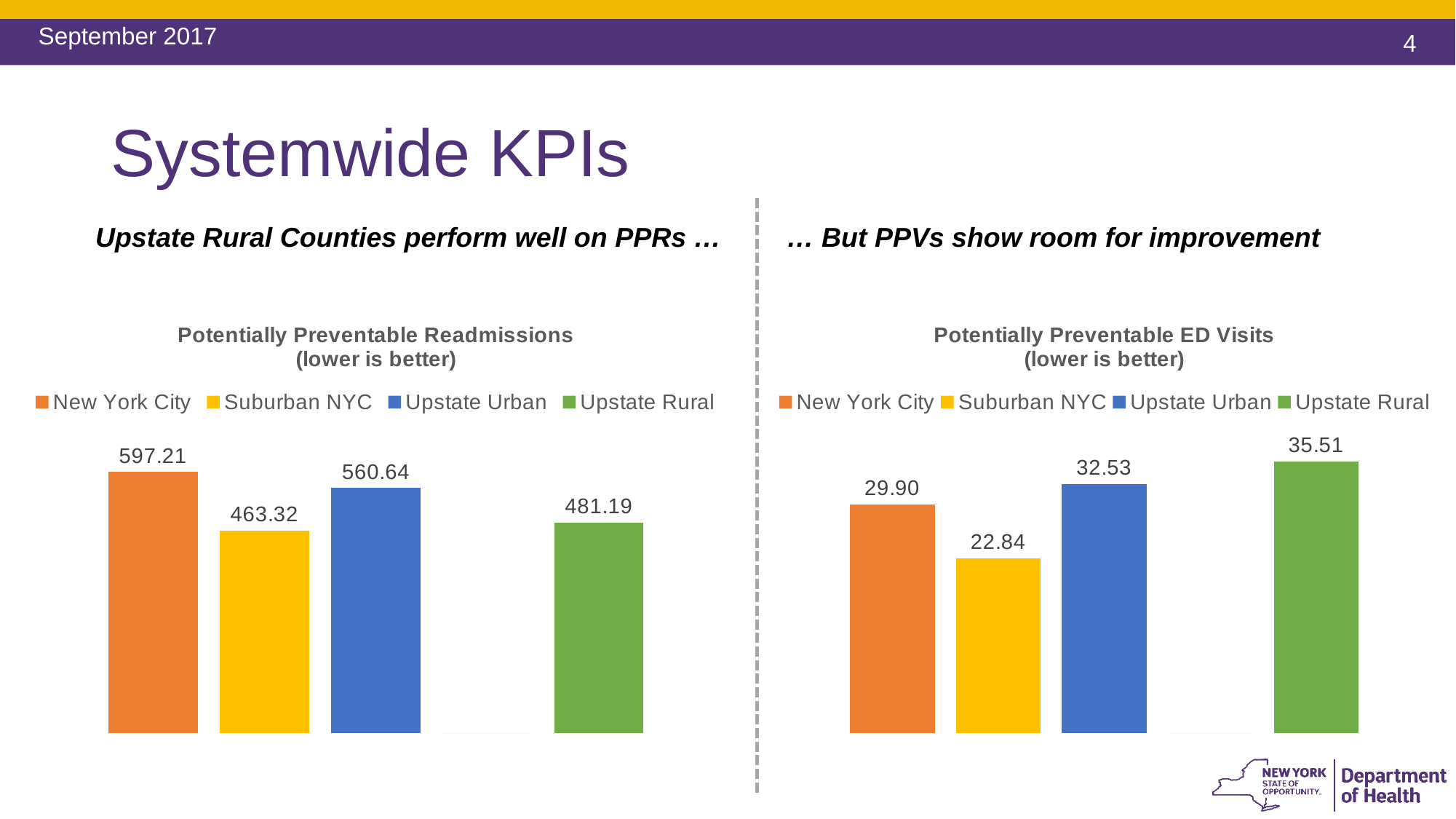
In the Potentially Preventable Readmissions chart, which region has the lowest value? Suburban NYC In the Potentially Preventable ED Visits chart, what colour is the Suburban NYC bar? Yellow In the Potentially Preventable Readmissions chart, what is the difference between New York City and Upstate Rural? 116.02 In the Potentially Preventable ED Visits chart, what is the difference between Upstate Rural and Suburban NYC? 12.67 In the Potentially Preventable ED Visits chart, what is the value for Upstate Rural? 35.51 In the Potentially Preventable ED Visits chart, which is larger, New York City or Upstate Urban? Upstate Urban In the Potentially Preventable Readmissions chart, which is larger, Upstate Urban or Upstate Rural? Upstate Urban In the Potentially Preventable Readmissions chart, what is the value for New York City? 597.21 In the Potentially Preventable ED Visits chart, which region has the highest value? Upstate Rural How many series does the legend of the Potentially Preventable ED Visits chart list? 4 In the Potentially Preventable Readmissions chart, what is the value for Upstate Urban? 560.64 What kind of chart is the Potentially Preventable Readmissions chart? Bar chart